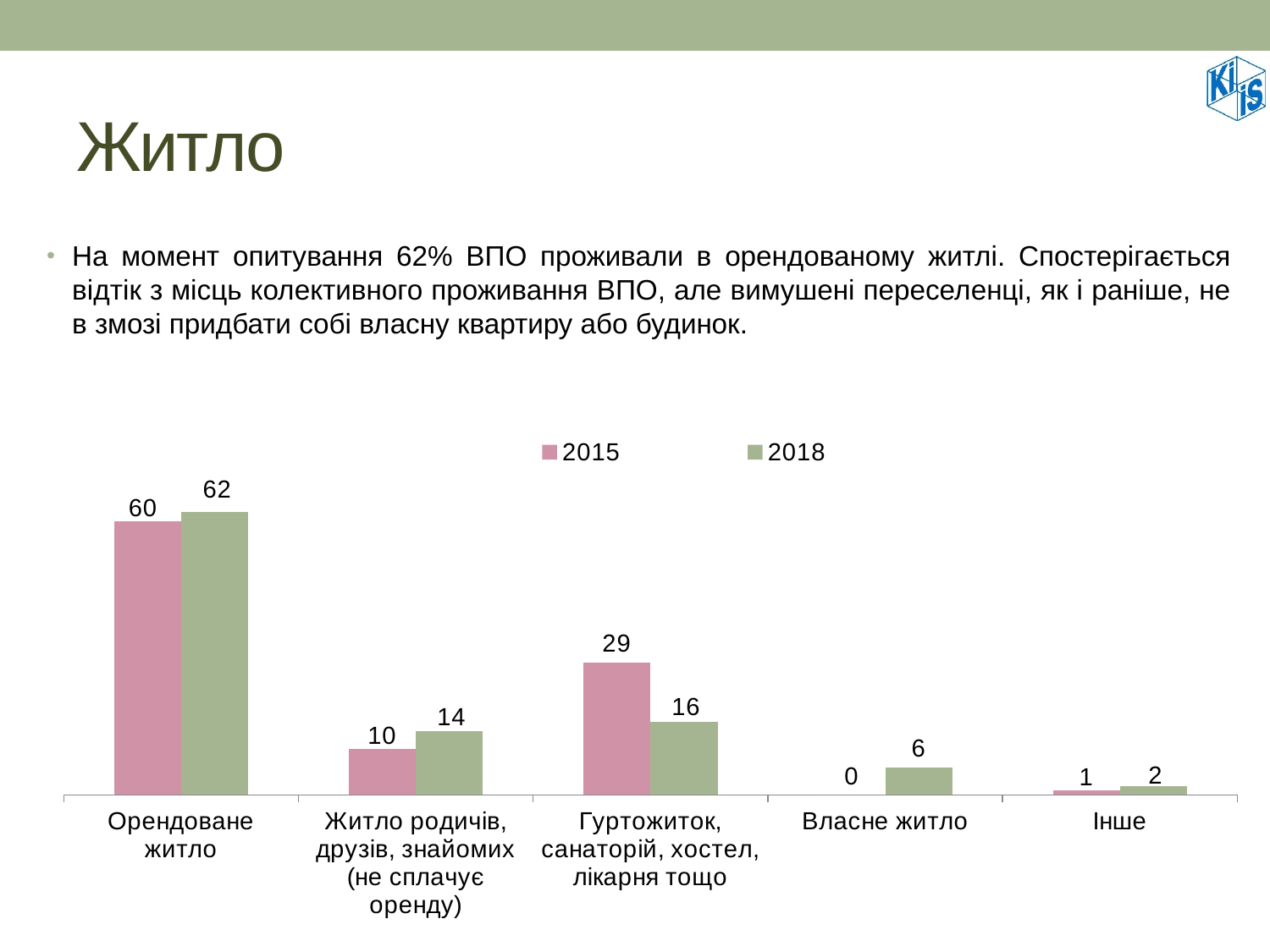
What is the 2015 value for Орендоване житло? 60 Which category has the highest 2018 value? Орендоване житло What is the difference between the 2018 values for Орендоване житло and Житло родичів, друзів, знайомих (не сплачує оренду)? 48 Which category has the lowest 2015 value? Власне житло How many categories are shown on the x axis? 5 Which series is shown in green in the legend? 2018 Which is larger for Житло родичів, друзів, знайомих (не сплачує оренду): the 2015 value or the 2018 value? 2018 What is the 2018 value for Гуртожиток, санаторій, хостел, лікарня тощо? 16 What is the 2018 value for Власне житло? 6 How many series does the legend list? 2 What is the difference between the 2015 and 2018 values for Гуртожиток, санаторій, хостел, лікарня тощо? 13 What kind of chart is shown on the slide? bar chart